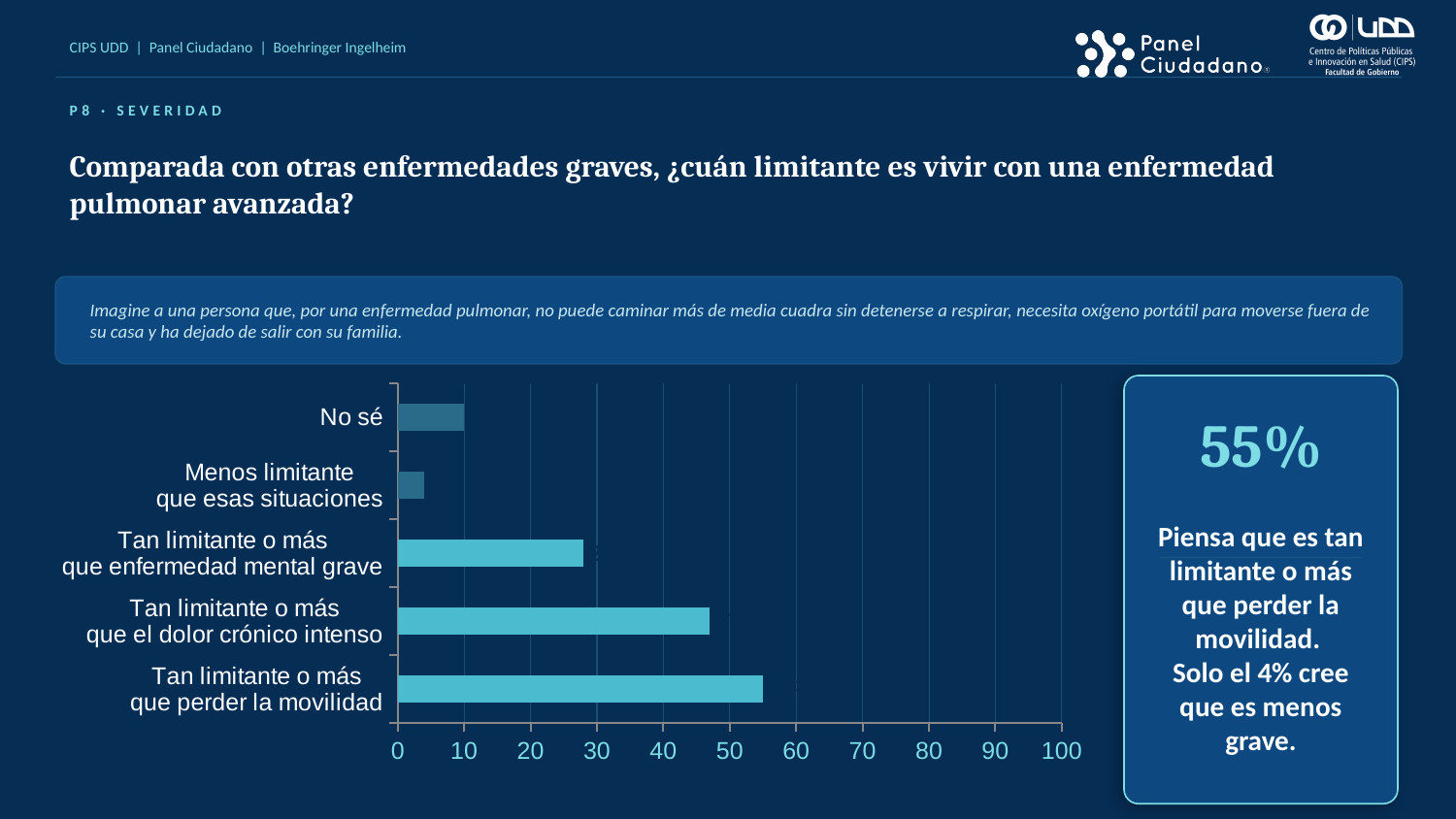
What percentage of respondents think it is less limiting than those situations (Menos limitante que esas situaciones)? 4% Is the value for 'Tan limitante o más que el dolor crónico intenso' greater or less than 40? greater What is the maximum value shown on the horizontal axis of the chart? 100 What kind of chart is shown on the slide? bar chart Is the value for 'No sé' greater or less than 20? less How many categories does the bar chart show? 5 Which is larger: the value for 'Tan limitante o más que el dolor crónico intenso' or the value for 'Tan limitante o más que enfermedad mental grave'? Tan limitante o más que el dolor crónico intenso Is the value for 'Tan limitante o más que enfermedad mental grave' greater or less than 30? less What percentage of respondents think it is as limiting or more than losing mobility (Tan limitante o más que perder la movilidad)? 55% Which category has the shortest bar in the chart? Menos limitante que esas situaciones Which category has the longest bar in the chart? Tan limitante o más que perder la movilidad Which is larger: the value for 'No sé' or the value for 'Menos limitante que esas situaciones'? No sé